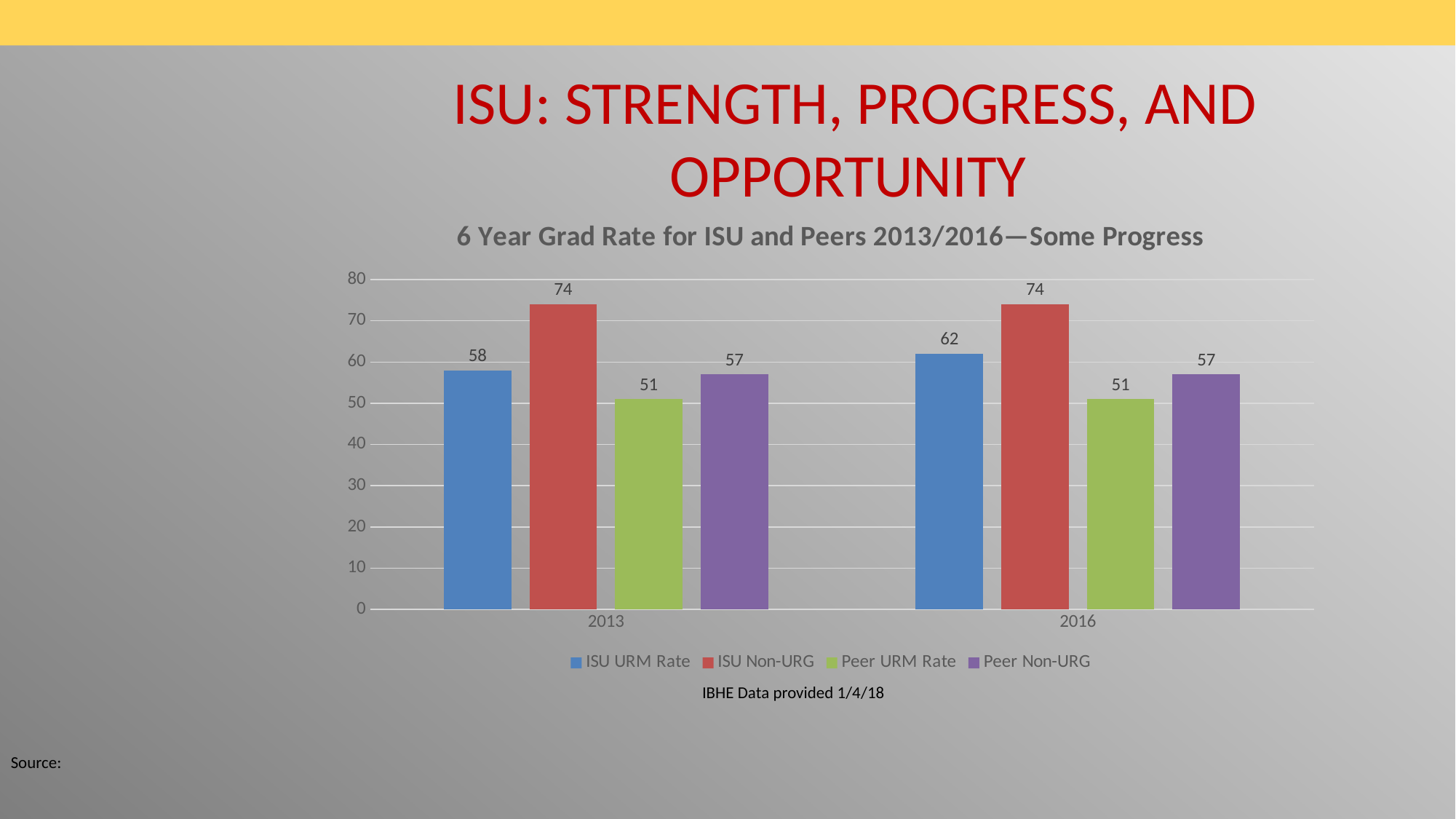
How many year categories are shown on the x axis? 2 What is the ISU URM Rate for 2016? 62 What is the Peer Non-URG value for 2016? 57 What kind of chart is shown on the slide? Bar chart Which series has the highest value in 2013? ISU Non-URG What is the difference between the ISU Non-URG and ISU URM Rate values in 2016? 12 By how much did the ISU URM Rate change from 2013 to 2016? 4 Which series has the lowest value in 2016? Peer URM Rate What is the title of the chart? 6 Year Grad Rate for ISU and Peers 2013/2016—Some Progress Which is larger in 2013, the ISU URM Rate or the Peer URM Rate? ISU URM Rate How many series does the legend list? 4 What is the ISU URM Rate for 2013? 58